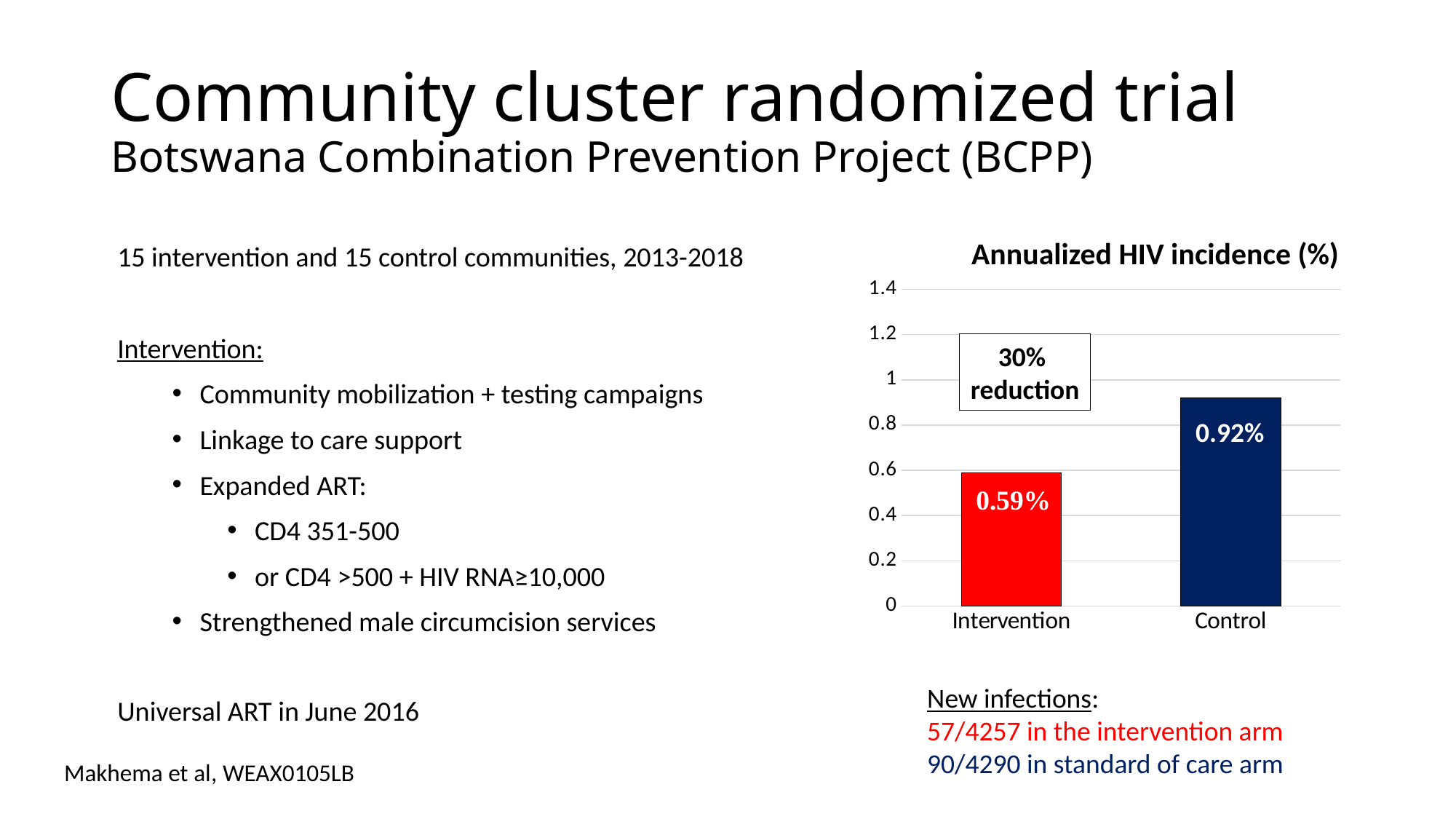
What percentage reduction is annotated on the chart? 30% reduction Is the value for Control greater or less than 1? less What is the annualized HIV incidence for the Intervention arm? 0.59% Is the annualized HIV incidence higher for Intervention or Control? Control What is the difference in annualized HIV incidence between the Control and Intervention arms? 0.33% Is the value for Intervention greater or less than 0.4? greater What is the annualized HIV incidence for the Control arm? 0.92% What is the title of the chart? Annualized HIV incidence (%) How many categories are shown on the x axis of the chart? 2 What kind of chart is shown on the slide? Bar chart Which arm has the higher annualized HIV incidence? Control Which arm has the lower annualized HIV incidence? Intervention